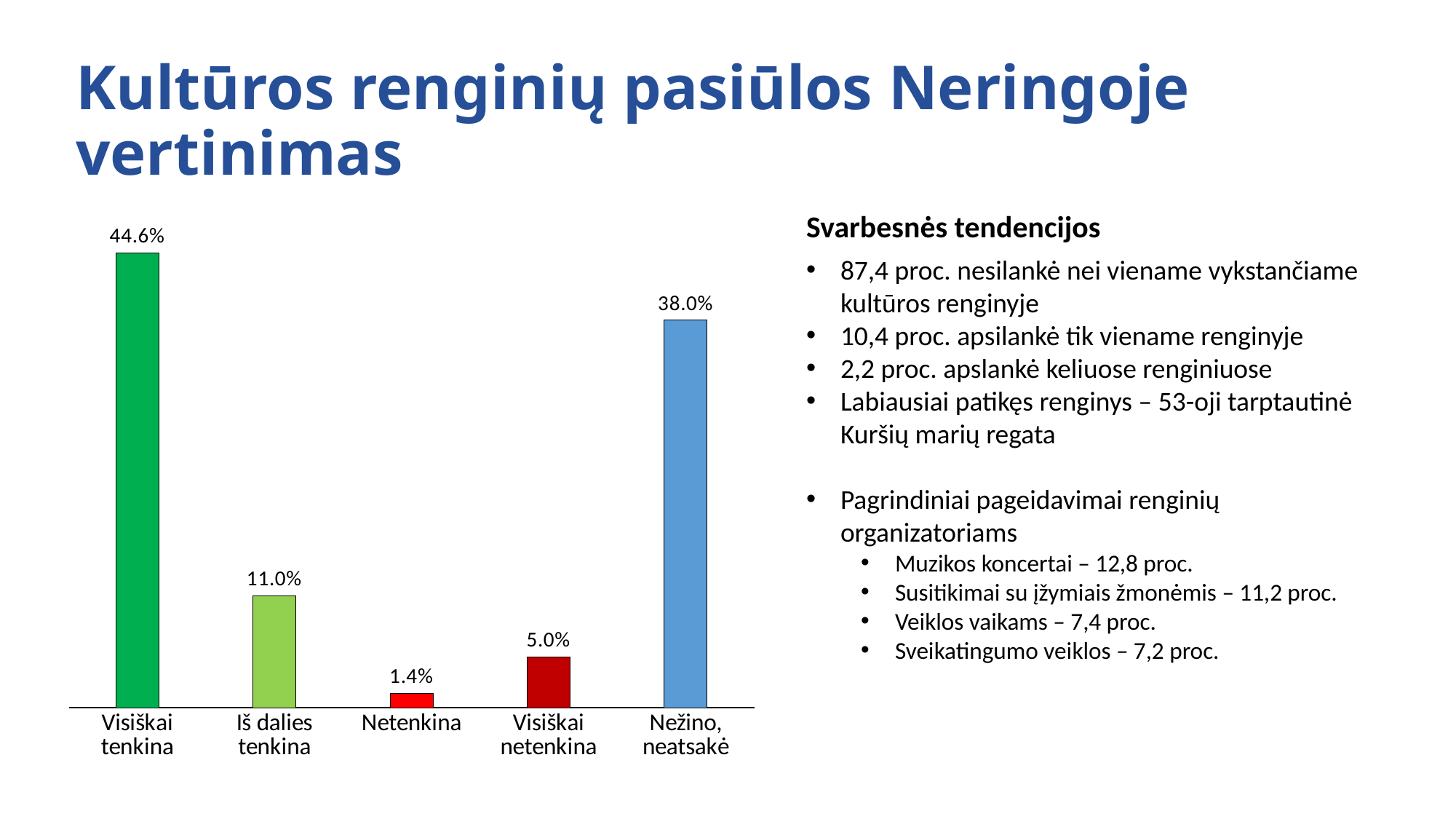
Which is larger, the value for "Iš dalies tenkina" or the value for "Visiškai netenkina"? Iš dalies tenkina What is the value for "Visiškai tenkina"? 44.6% What is the difference between the values for "Visiškai tenkina" and "Nežino, neatsakė"? 6.6% What is the value for "Nežino, neatsakė"? 38.0% What is the value for "Visiškai netenkina"? 5.0% What is the value for "Iš dalies tenkina"? 11.0% How many categories are shown in the chart? 5 Which category has the lowest value? Netenkina What colour is the bar for "Nežino, neatsakė"? Blue Which category has the highest value? Visiškai tenkina What is the value for "Netenkina"? 1.4% What kind of chart is shown on the slide? Bar chart